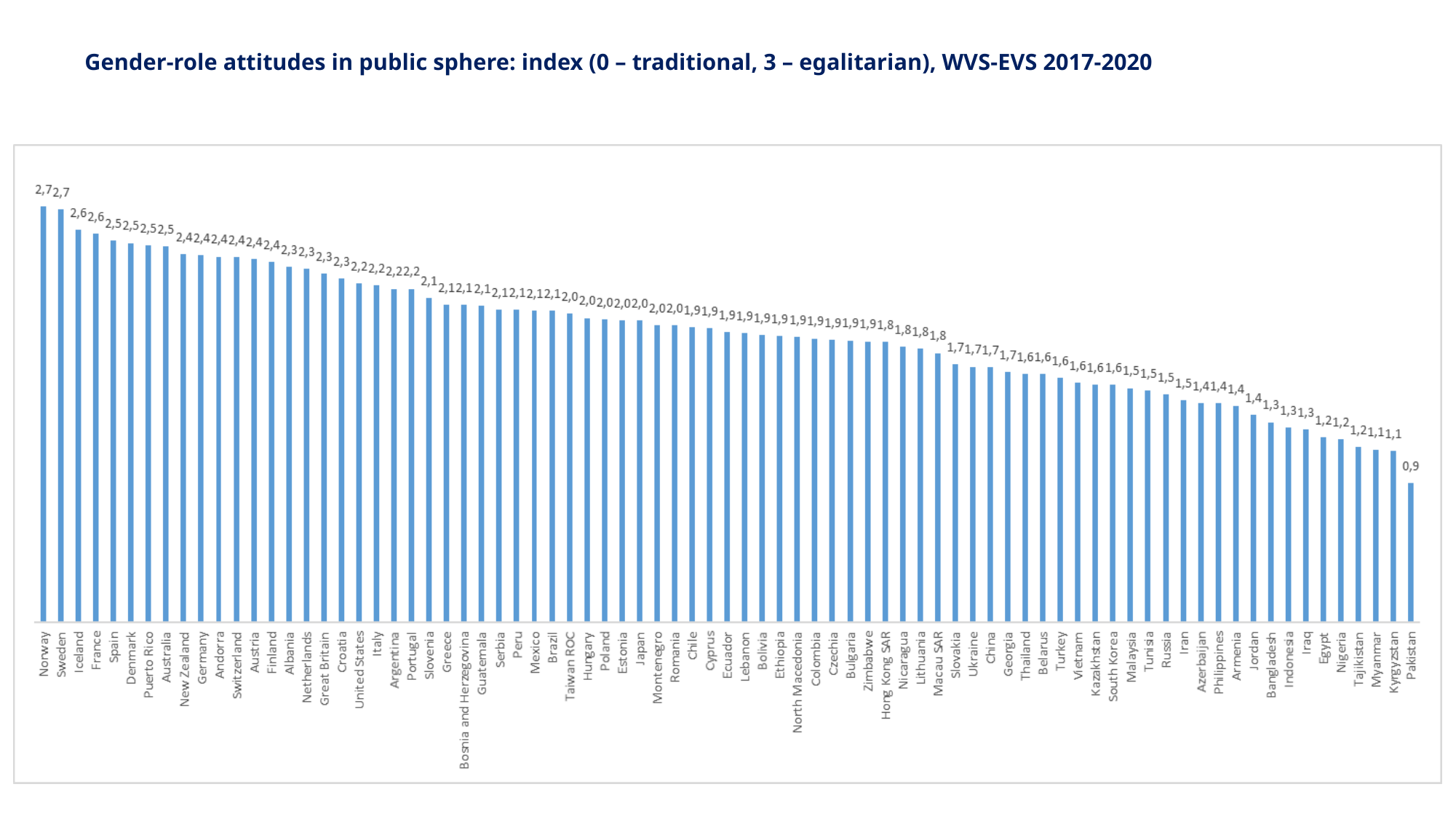
What is the index value for Kyrgyzstan? 1,1 Which country is shown with the highest index value at the far left of the chart? Norway Do the index values rise or fall moving from left to right across the chart? Fall What kind of chart is shown on the slide? Bar chart According to the title, what does an index value of 3 represent? Egalitarian What is the index value for Sweden? 2,7 What is the difference between the index values of Norway and Pakistan? 1,8 What is the index value for Iceland? 2,6 Which country has the lowest index value? Pakistan What is the index value for Norway? 2,7 What is the index value for Pakistan? 0,9 Which has a higher index value, France or Myanmar? France